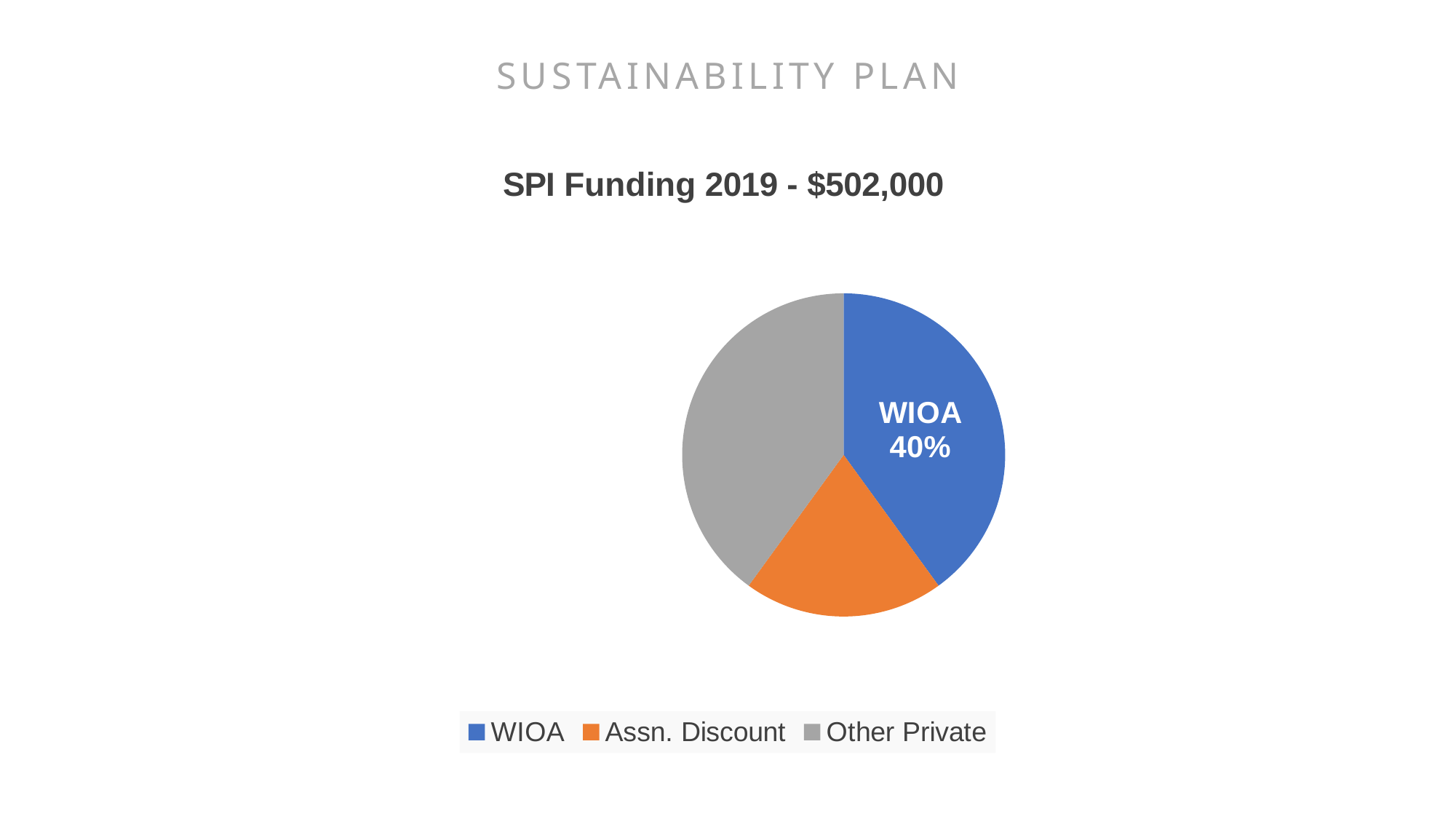
How many entries does the legend list? 3 How many slices does the pie chart have? 3 What colour is the WIOA slice in the pie chart? blue What is the value printed on the WIOA slice? 40% What share of SPI Funding 2019 does the WIOA slice represent? 40% Which slice is larger, Other Private or Assn. Discount? Other Private What is the title of the chart? SPI Funding 2019 - $502,000 Which slice is larger, WIOA or Assn. Discount? WIOA What kind of chart is shown on the slide? pie chart Which funding source has the smallest slice of the pie? Assn. Discount